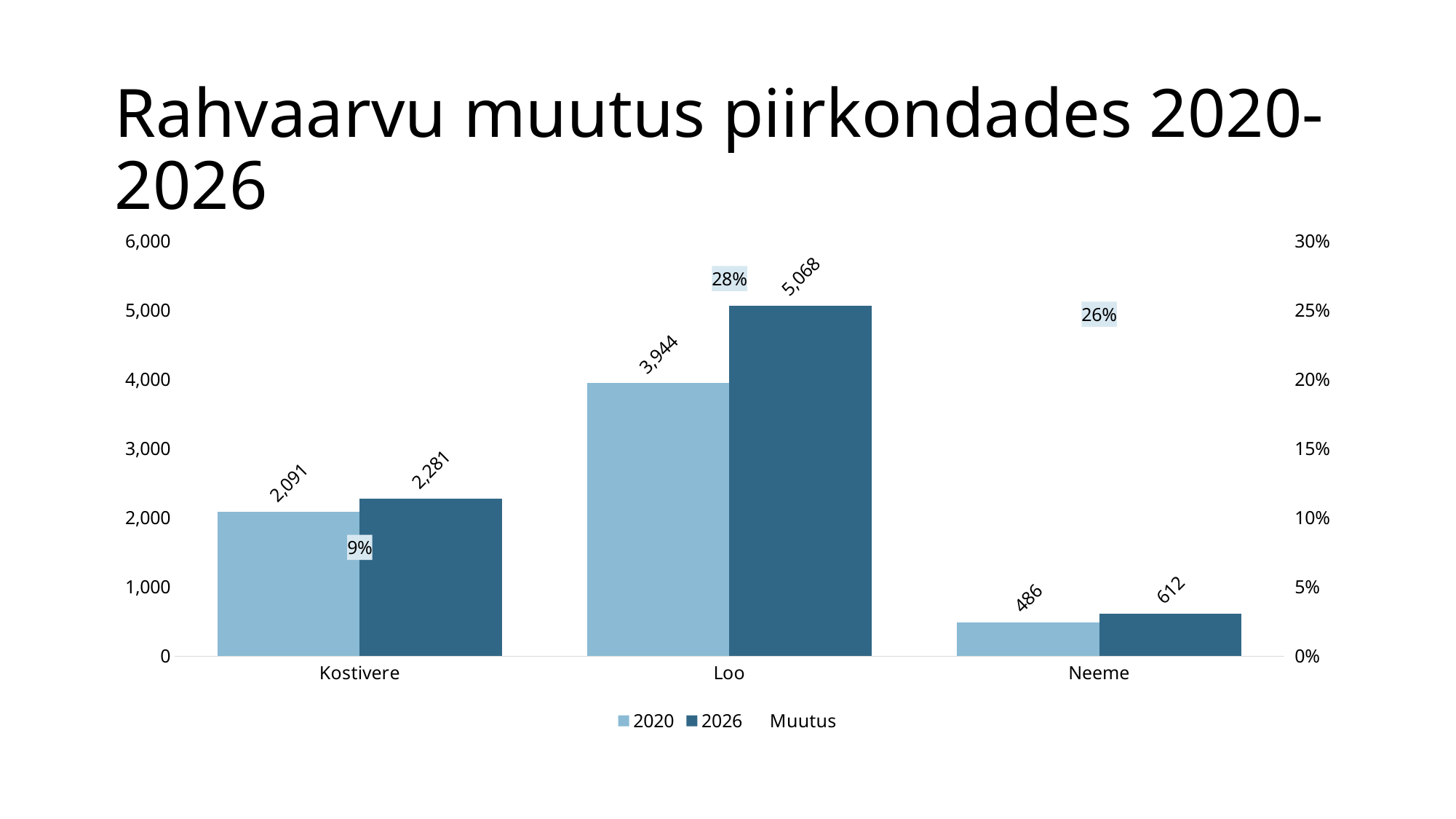
What is the Muutus value for Neeme? 26% What is the difference between the 2026 and 2020 values for Loo? 1,124 How many categories are shown on the x axis? 3 What is the 2026 value for Kostivere? 2,281 Which is larger, the 2026 value for Neeme or the 2020 value for Kostivere? 2020 value for Kostivere Which category has the highest 2026 value? Loo Which category has the lowest 2020 value? Neeme What kind of chart is shown on the slide? Bar chart Which category has the lowest Muutus value? Kostivere What is the 2020 value for Loo? 3,944 What is the title of the chart? Rahvaarvu muutus piirkondades 2020-2026 How many series does the legend list? 3